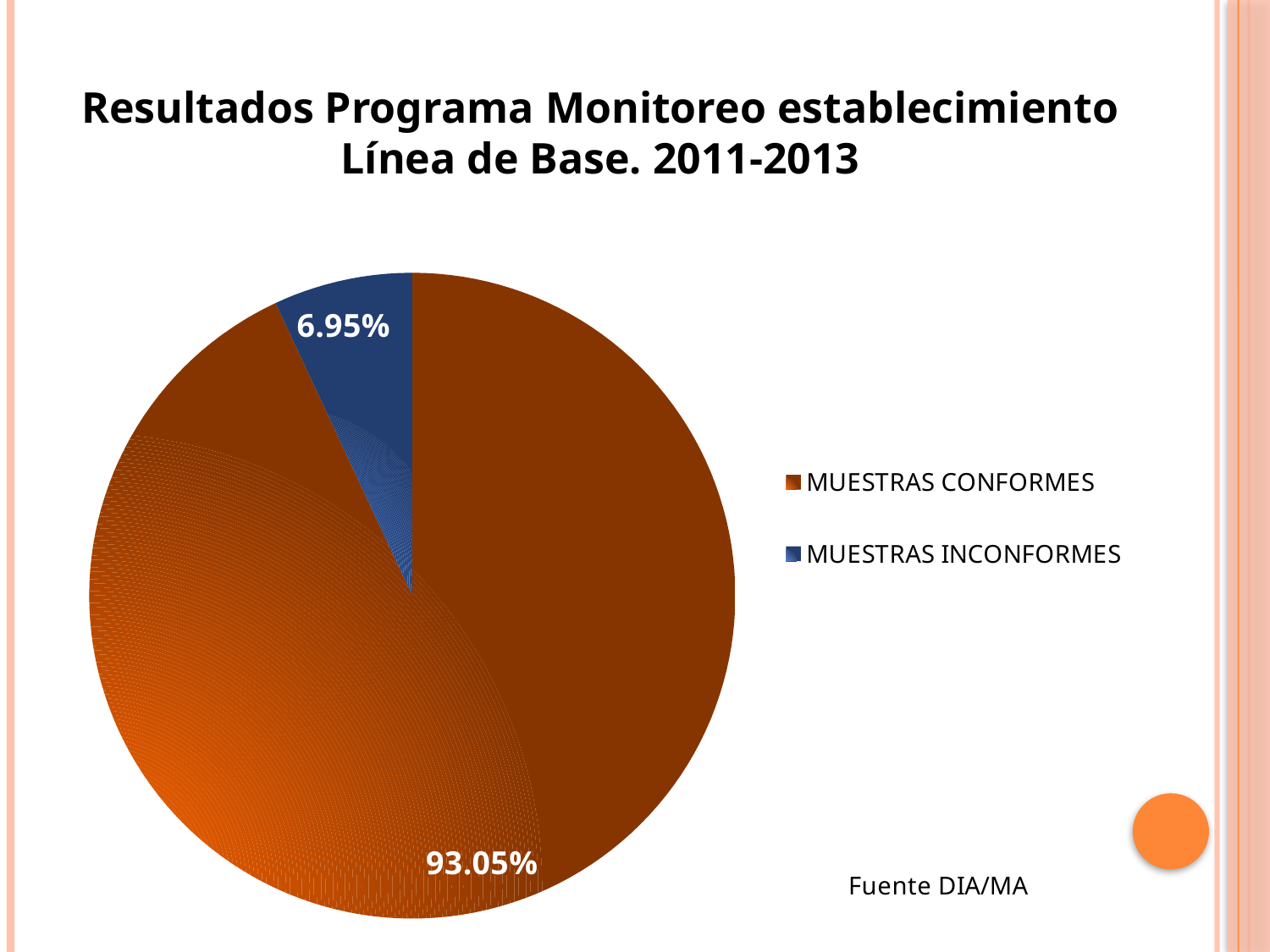
Which category has the smallest slice of the pie? MUESTRAS INCONFORMES What is the difference in percentage points between MUESTRAS CONFORMES and MUESTRAS INCONFORMES? 86.1 What share of the pie is MUESTRAS INCONFORMES? 6.95% What source is cited below the chart? Fuente DIA/MA How many slices does the pie chart have? 2 What kind of chart is shown on the slide? Pie chart What share of the pie is MUESTRAS CONFORMES? 93.05% What colour is the MUESTRAS INCONFORMES slice? Blue Which category has the largest slice of the pie? MUESTRAS CONFORMES Which is larger, MUESTRAS CONFORMES or MUESTRAS INCONFORMES? MUESTRAS CONFORMES How many entries does the legend list? 2